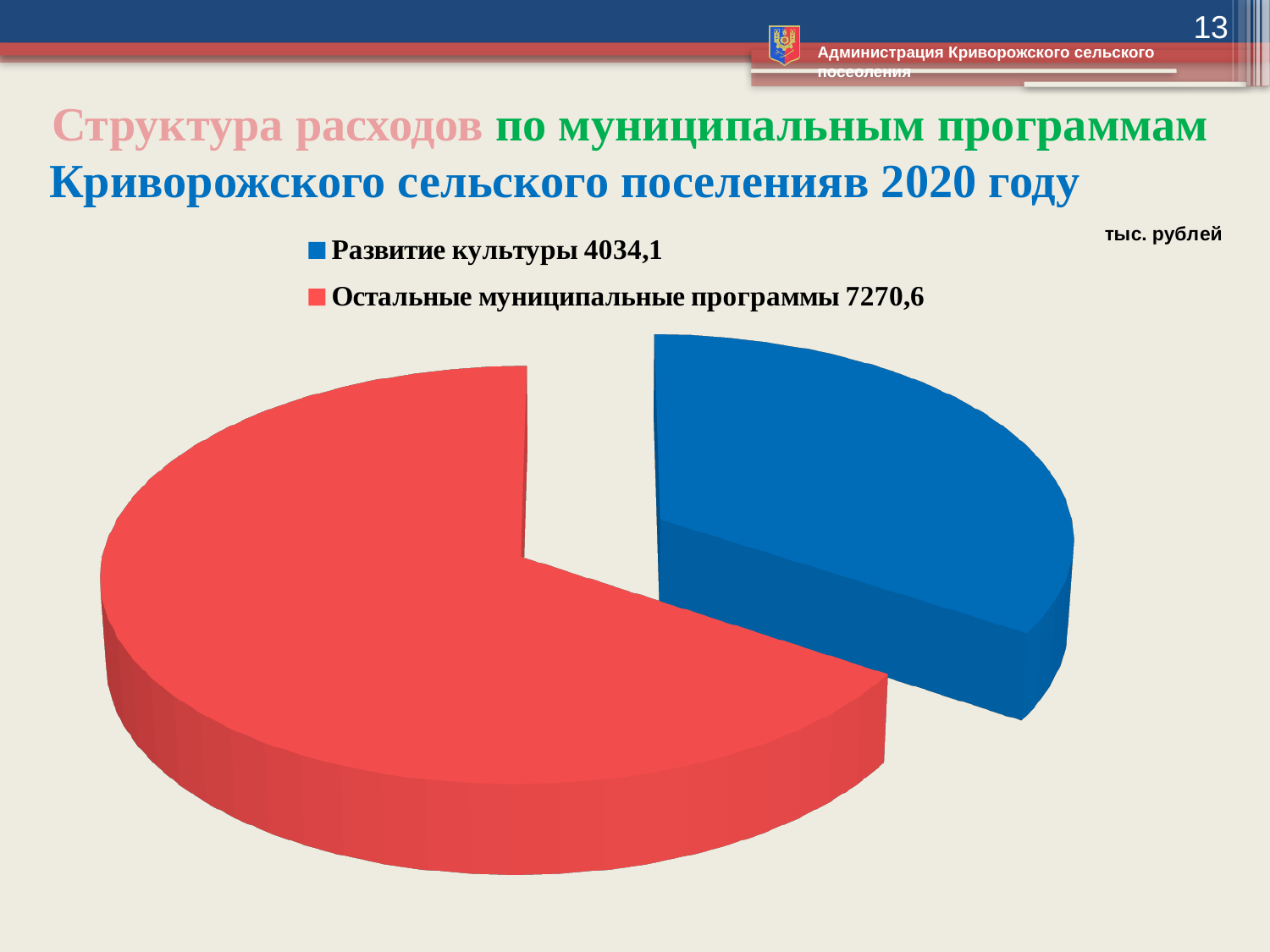
Which category has the largest slice of the pie? Остальные муниципальные программы What is the difference between Остальные муниципальные программы and Развитие культуры? 3236,5 How many slices does the pie chart have? 2 How many entries does the legend list? 2 What is the value for Развитие культуры? 4034,1 What kind of chart is shown on the slide? pie chart Which is larger: Развитие культуры or Остальные муниципальные программы? Остальные муниципальные программы In what units are the values on the chart given? тыс. рублей Which category has the smallest slice of the pie? Развитие культуры What is the value for Остальные муниципальные программы? 7270,6 What colour is the slice for Развитие культуры? blue What is the total of the two values shown in the legend? 11304,7